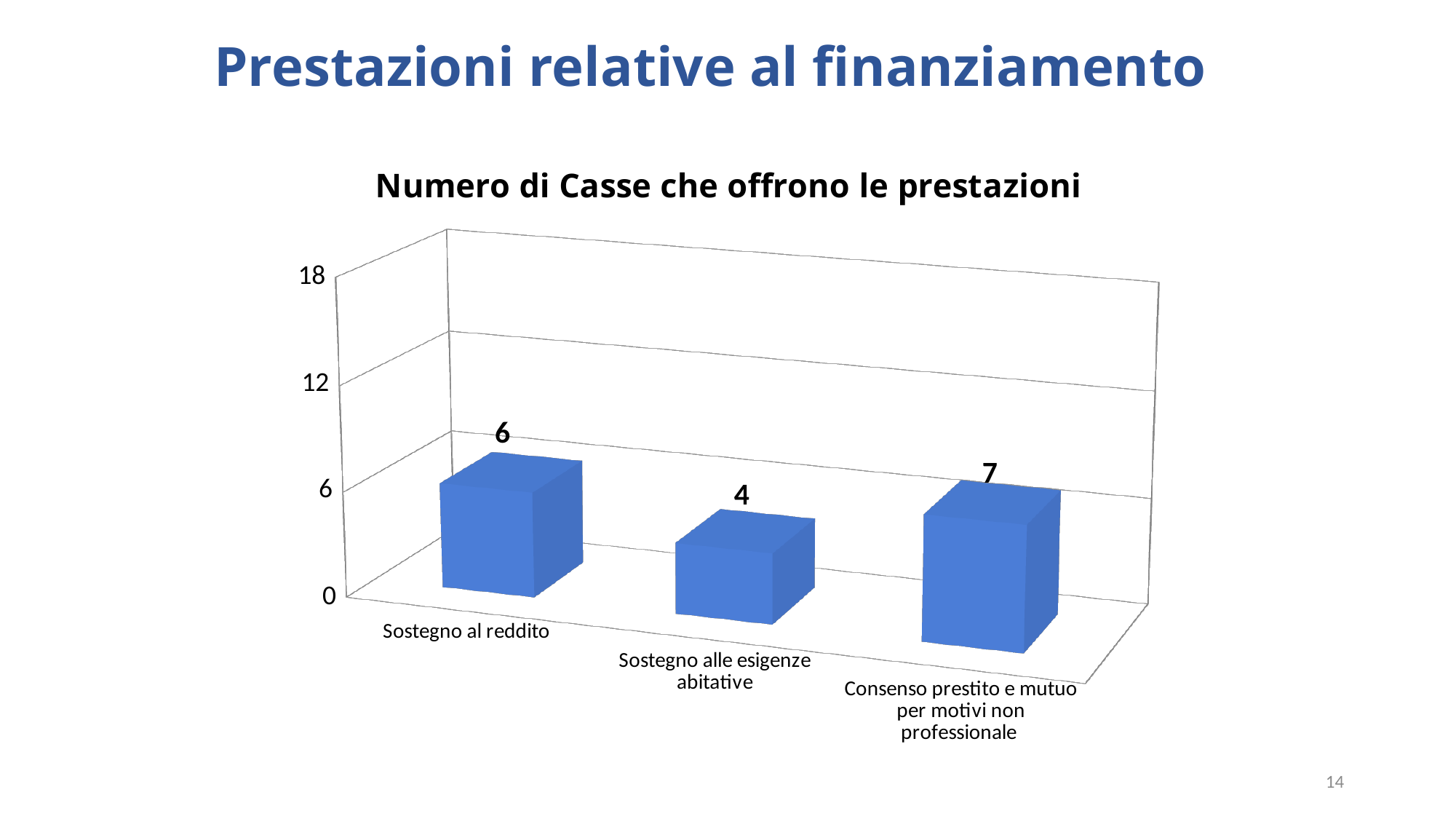
How many categories are shown in the chart? 3 What is the difference between the values for Sostegno al reddito and Sostegno alle esigenze abitative? 2 What is the difference between the values for Consenso prestito e mutuo per motivi non professionale and Sostegno alle esigenze abitative? 3 What is the value for Consenso prestito e mutuo per motivi non professionale? 7 What is the title of the chart? Numero di Casse che offrono le prestazioni Is the value for Sostegno alle esigenze abitative greater or less than 6? less What is the value for Sostegno al reddito? 6 Which is larger, the value for Sostegno al reddito or the value for Consenso prestito e mutuo per motivi non professionale? Consenso prestito e mutuo per motivi non professionale Which category has the lowest value? Sostegno alle esigenze abitative What kind of chart is shown on the slide? bar chart What is the value for Sostegno alle esigenze abitative? 4 Which category has the highest value? Consenso prestito e mutuo per motivi non professionale